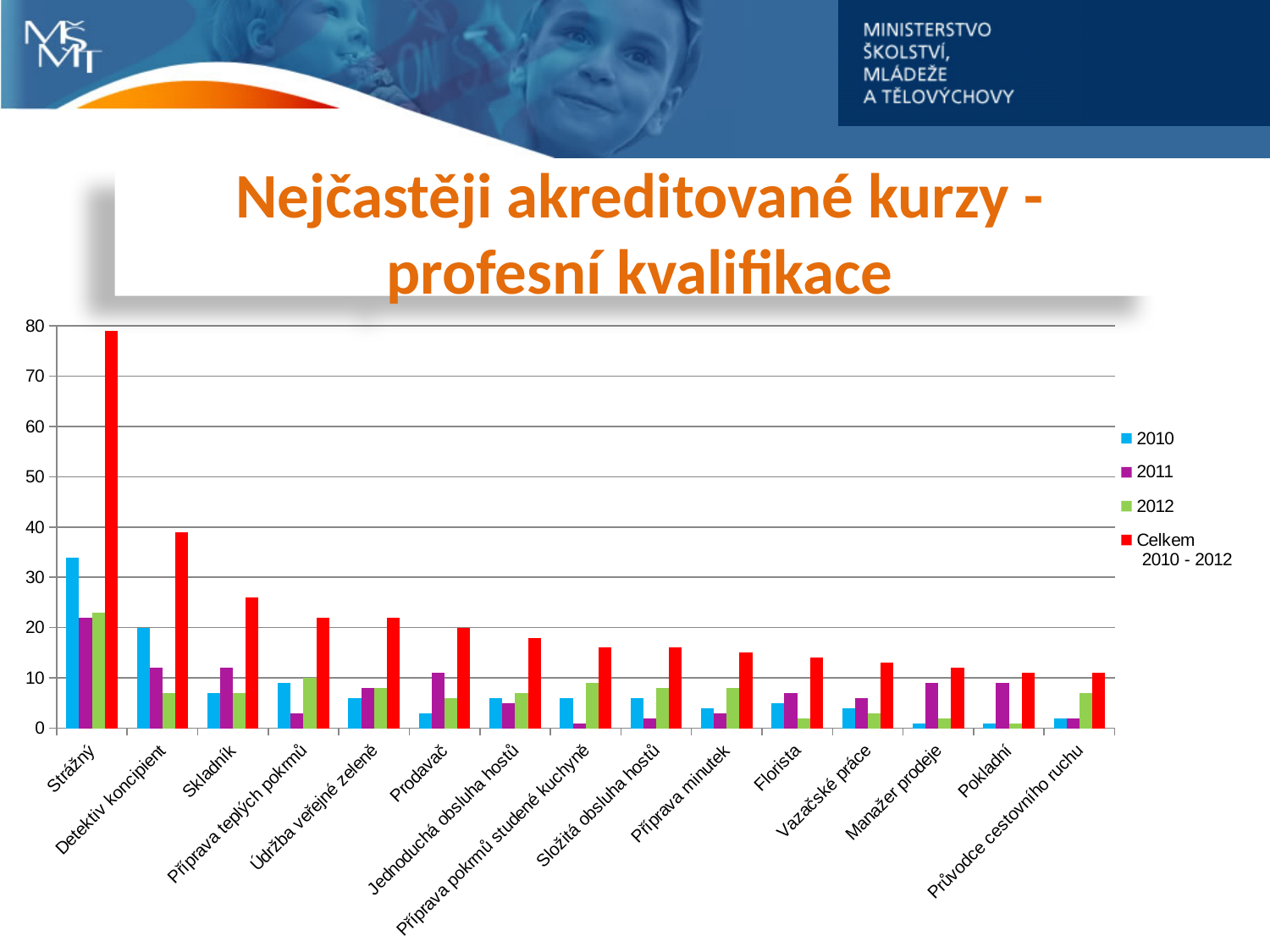
Is the 2010 value for Strážný greater or less than 30? greater How many series does the legend list? 4 What type of chart is shown on the slide? bar chart Is the 2010 value for Manažer prodeje greater or less than 10? less Is the Celkem 2010 - 2012 value for Skladník greater or less than 20? greater How many categories (courses) are shown on the x axis? 15 Which is larger for Prodavač: the 2010 value or the 2011 value? 2011 What colour are the bars for the Celkem 2010 - 2012 series? red Which category has the highest value for the Celkem 2010 - 2012 series? Strážný Which category has the larger 2010 value: Strážný or Detektiv koncipient? Strážný